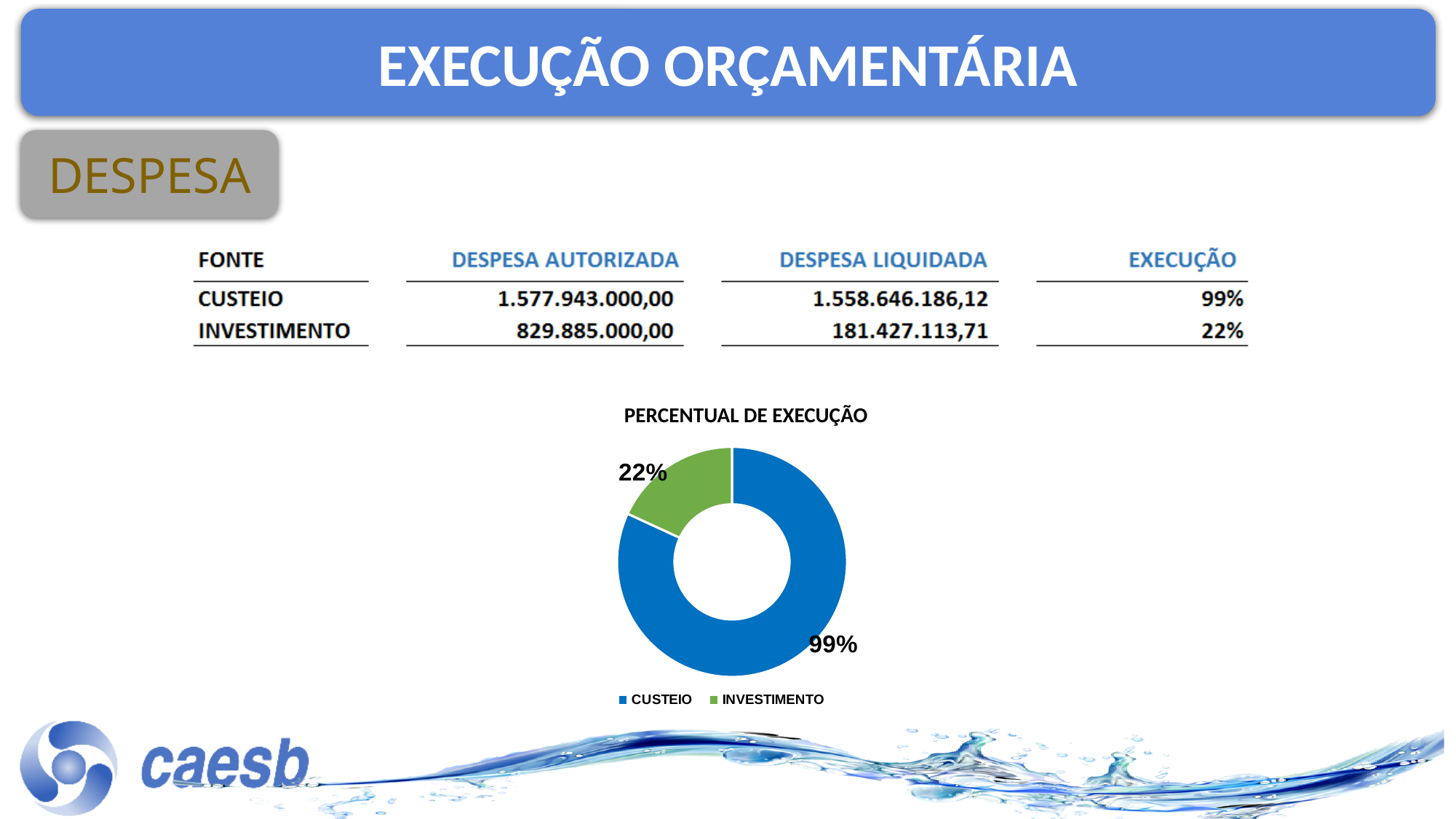
Which category is shown in green in the chart? INVESTIMENTO What value is labelled on the INVESTIMENTO slice of the chart? 22% How many categories does the chart's legend list? 2 What colour is the CUSTEIO slice in the chart? Blue What value is labelled on the CUSTEIO slice of the chart? 99% Which is larger in the chart, the value for CUSTEIO or the value for INVESTIMENTO? CUSTEIO Which category has the lowest value in the chart? INVESTIMENTO What kind of chart is shown under the title PERCENTUAL DE EXECUÇÃO? Doughnut (pie) chart How many slices does the doughnut chart have? 2 Which category has the highest value in the chart? CUSTEIO What is the difference between the CUSTEIO and INVESTIMENTO values shown in the chart? 77% What is the title of the chart on the slide? PERCENTUAL DE EXECUÇÃO